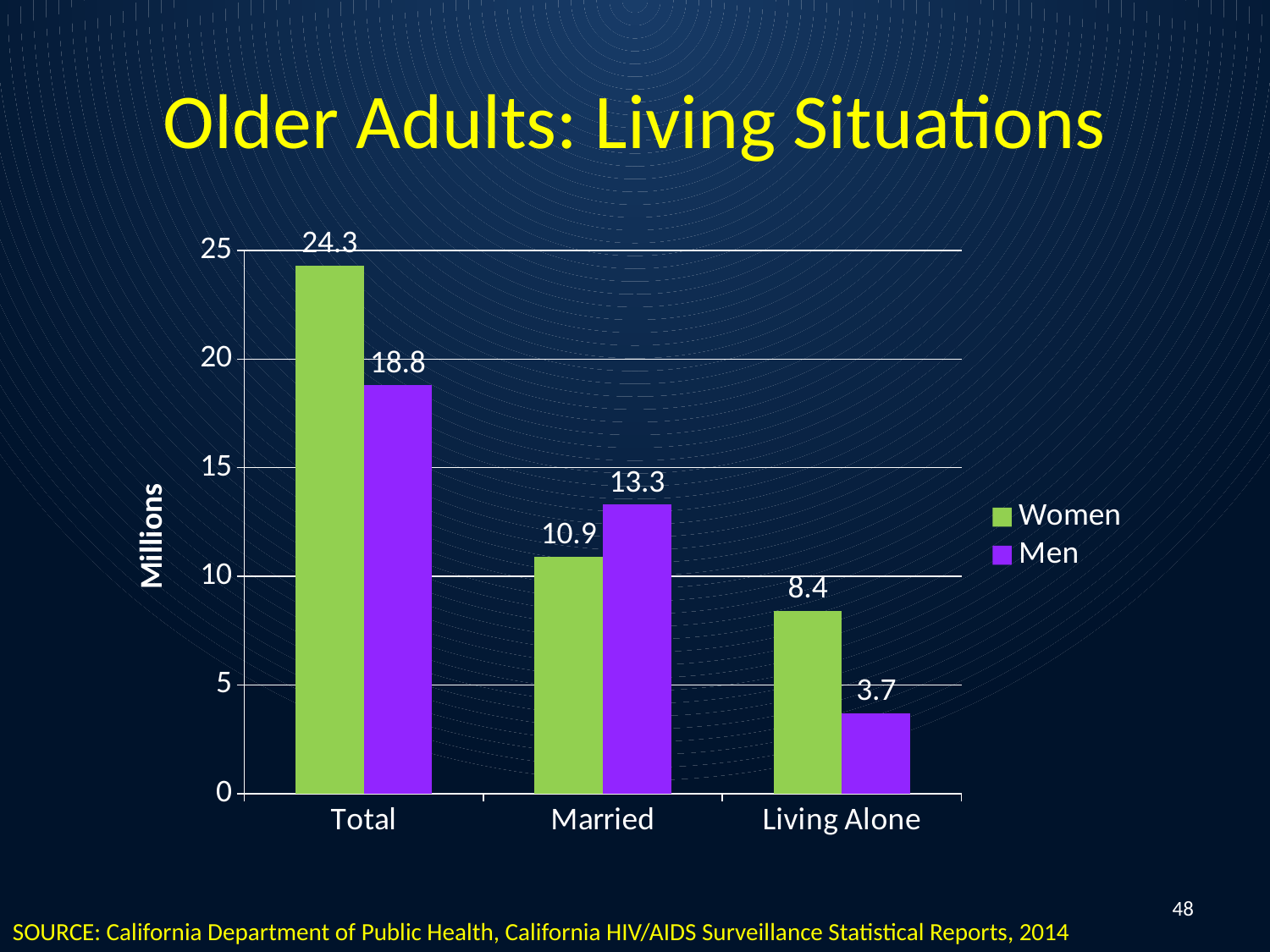
How many series does the legend list? 2 Which category has the lowest value for Men? Living Alone Which category has the highest value for Women? Total How many categories are shown on the x axis? 3 What is the value for Men in the Living Alone category? 3.7 What is the difference between Women and Men in the Living Alone category? 4.7 What is the label of the y axis? Millions What is the value for Women in the Total category? 24.3 In the Married category, which is larger, Women or Men? Men What kind of chart is shown on the slide? Bar chart What colour represents Men in the chart? Purple What is the value for Men in the Married category? 13.3